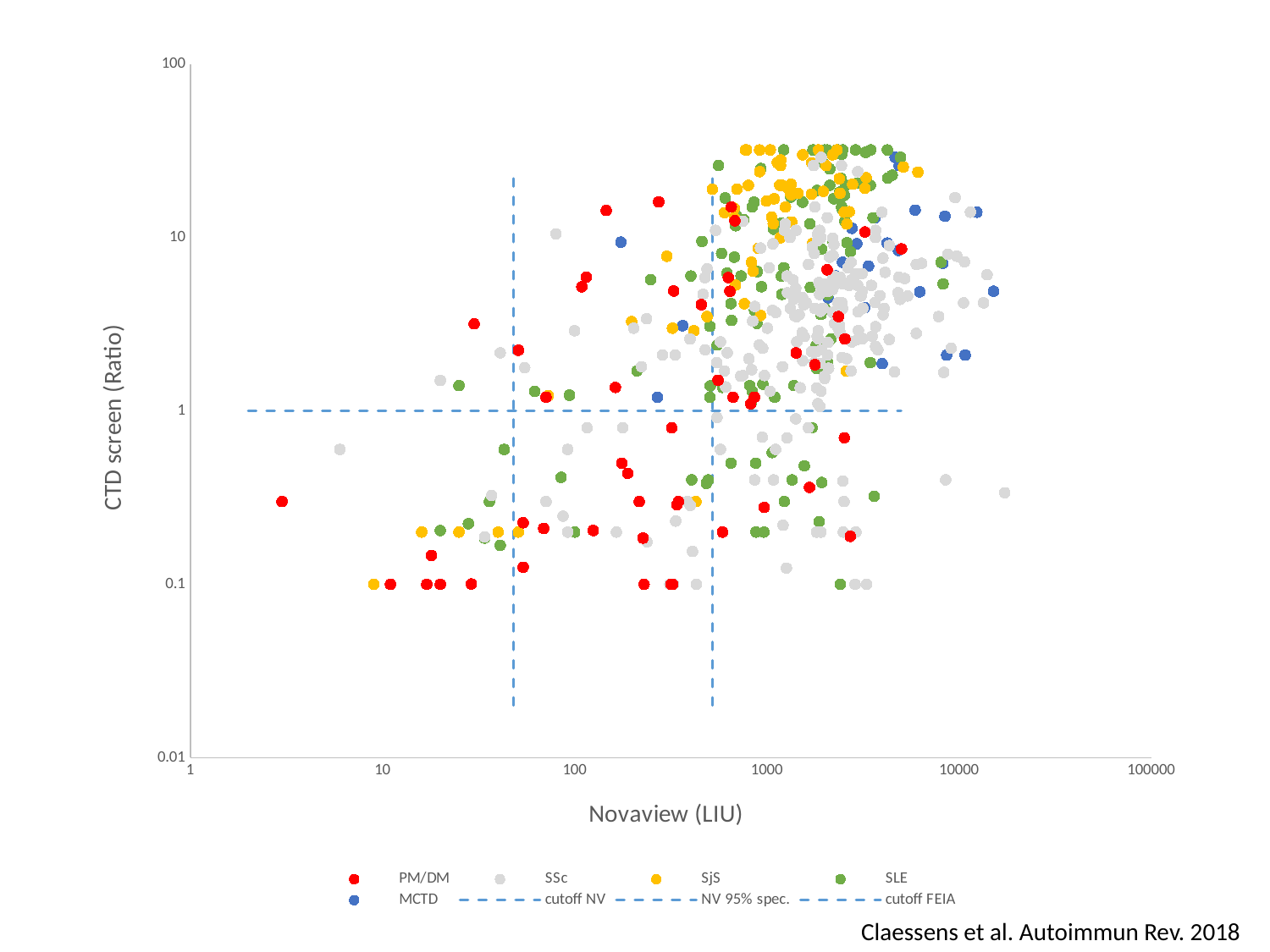
Is the largest Novaview value plotted on the chart greater or less than 100000? less What is the title of the x axis? Novaview (LIU) How many entries does the legend list? 8 Which colour represents the SjS series in the legend? yellow Is the lowest CTD screen ratio plotted on the chart greater or less than 0.01? greater Are the yellow SjS points mostly above or below the horizontal dashed line at 1? above Is the CTD screen ratio of the leftmost plotted point (the red point near 3 LIU) greater or less than 1? less What kind of chart is shown on the slide? scatter plot At what value on the y axis is the horizontal dashed cutoff line drawn? 1